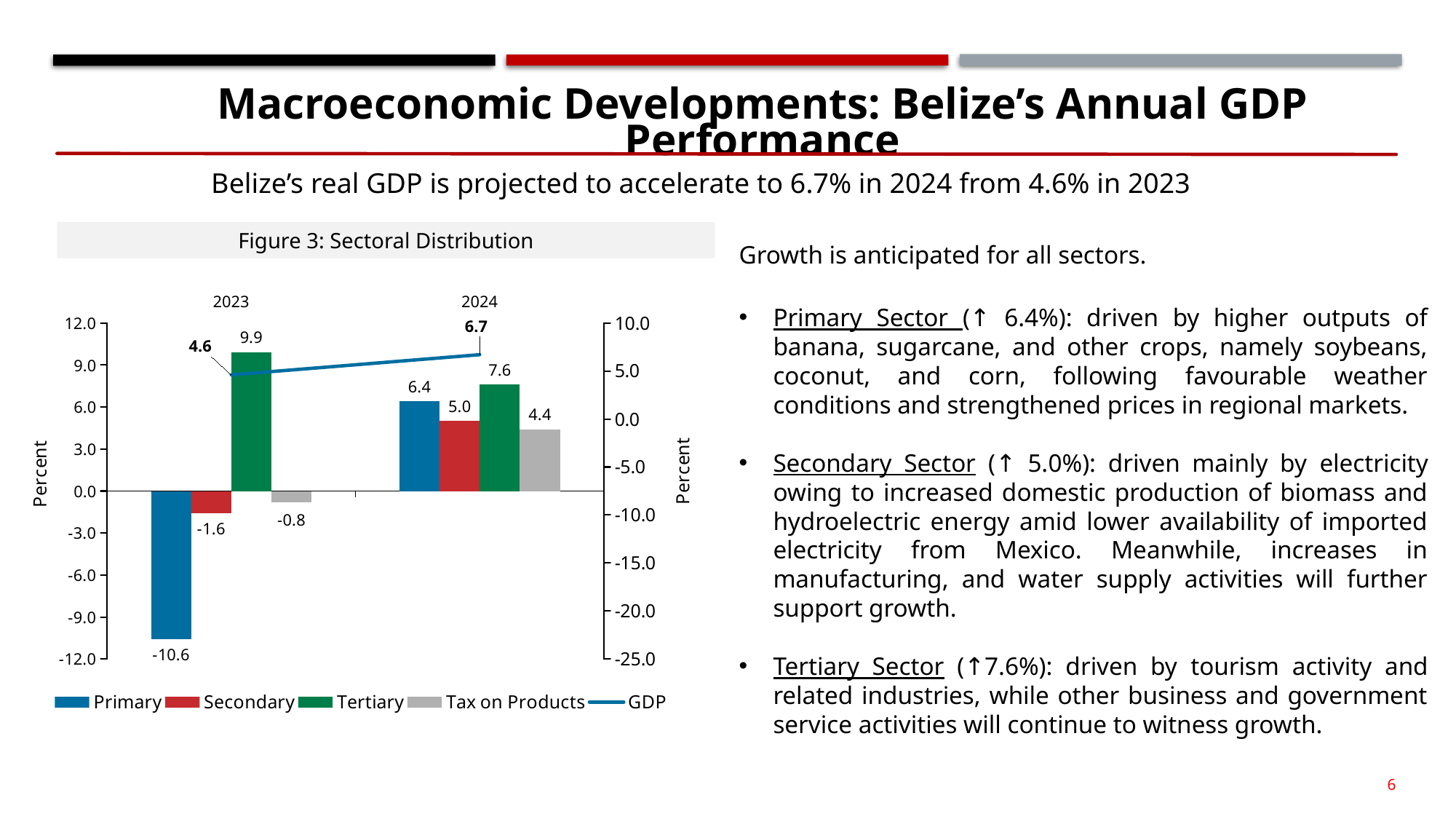
How many series does the legend list? 5 What is the difference between the GDP values for 2024 and 2023? 2.1 What is the difference between the Tertiary sector values in 2023 and 2024? 2.3 What is the title of the chart? Figure 3: Sectoral Distribution What is the value for the Primary sector in 2023? -10.6 Which sector has the highest value in 2023? Tertiary What is the GDP value shown for 2024? 6.7 Does the GDP line rise or fall from 2023 to 2024? rise What is the value for Tax on Products in 2023? -0.8 Which is larger in 2024, the Primary sector or the Secondary sector? Primary Which sector has the lowest value in 2024? Tax on Products What is the value for the Tertiary sector in 2024? 7.6